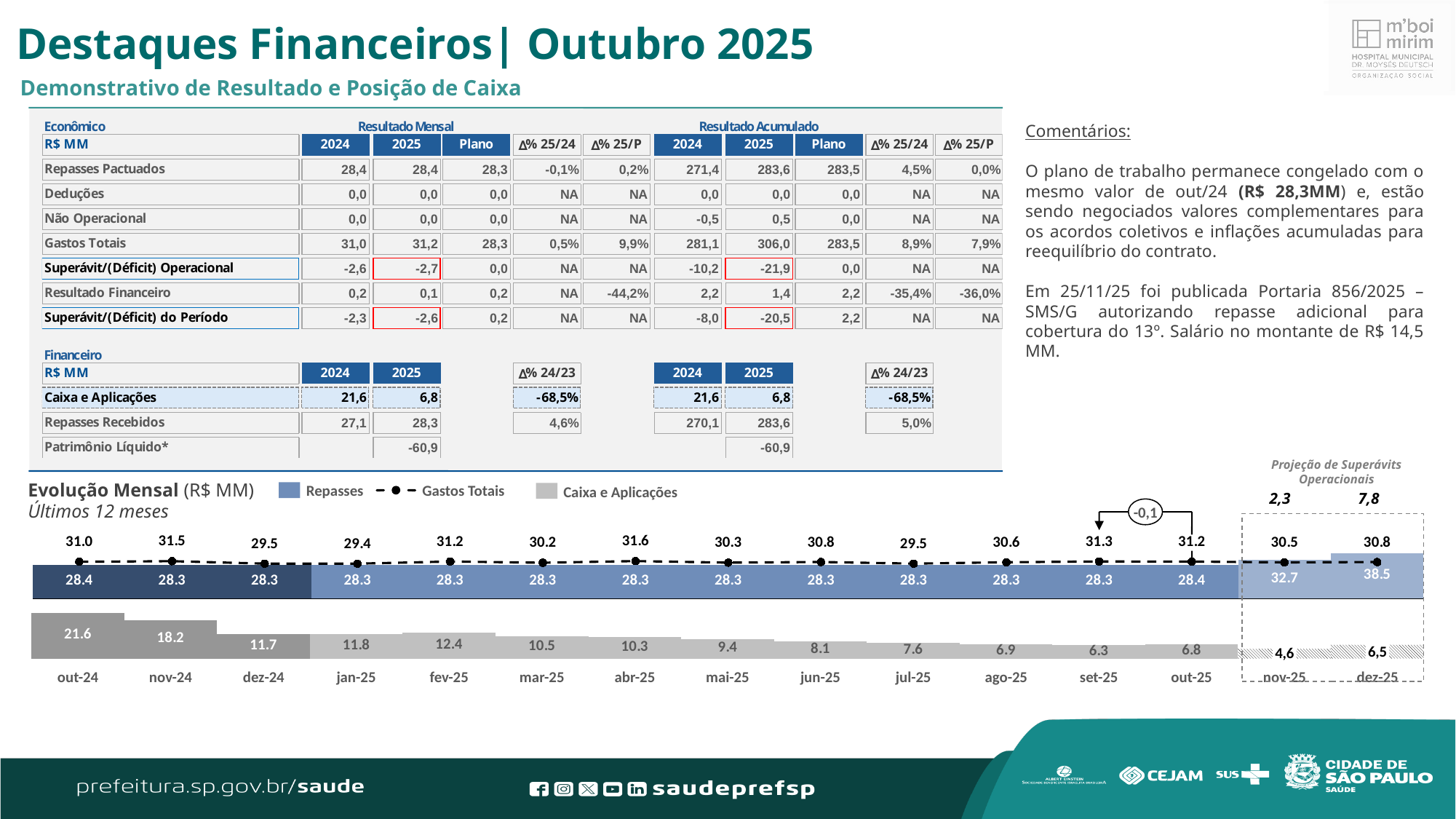
How many months are shown on the x axis of the Evolução Mensal chart? 15 In the Evolução Mensal chart, what is the value of Caixa e Aplicações for out-24? 21.6 In the Evolução Mensal chart, which month has the lowest Caixa e Aplicações value? nov-25 In the Evolução Mensal chart, which month has the highest Gastos Totais value? abr-25 How many series does the legend of the Evolução Mensal chart list? 3 In the Evolução Mensal chart, which is larger in out-25: Gastos Totais or Repasses? Gastos Totais In the Evolução Mensal chart, what is the Repasses value for dez-25? 38.5 In the Evolução Mensal chart, does Caixa e Aplicações rise or fall from out-24 to out-25? Fall In the Evolução Mensal chart, what is the difference between Caixa e Aplicações in out-24 and in out-25? 14.8 In the Evolução Mensal chart, what colour represents Caixa e Aplicações in the legend? Grey What kind of chart is the Evolução Mensal chart? Bar and line chart In the Evolução Mensal chart, what is the value of Gastos Totais for abr-25? 31.6